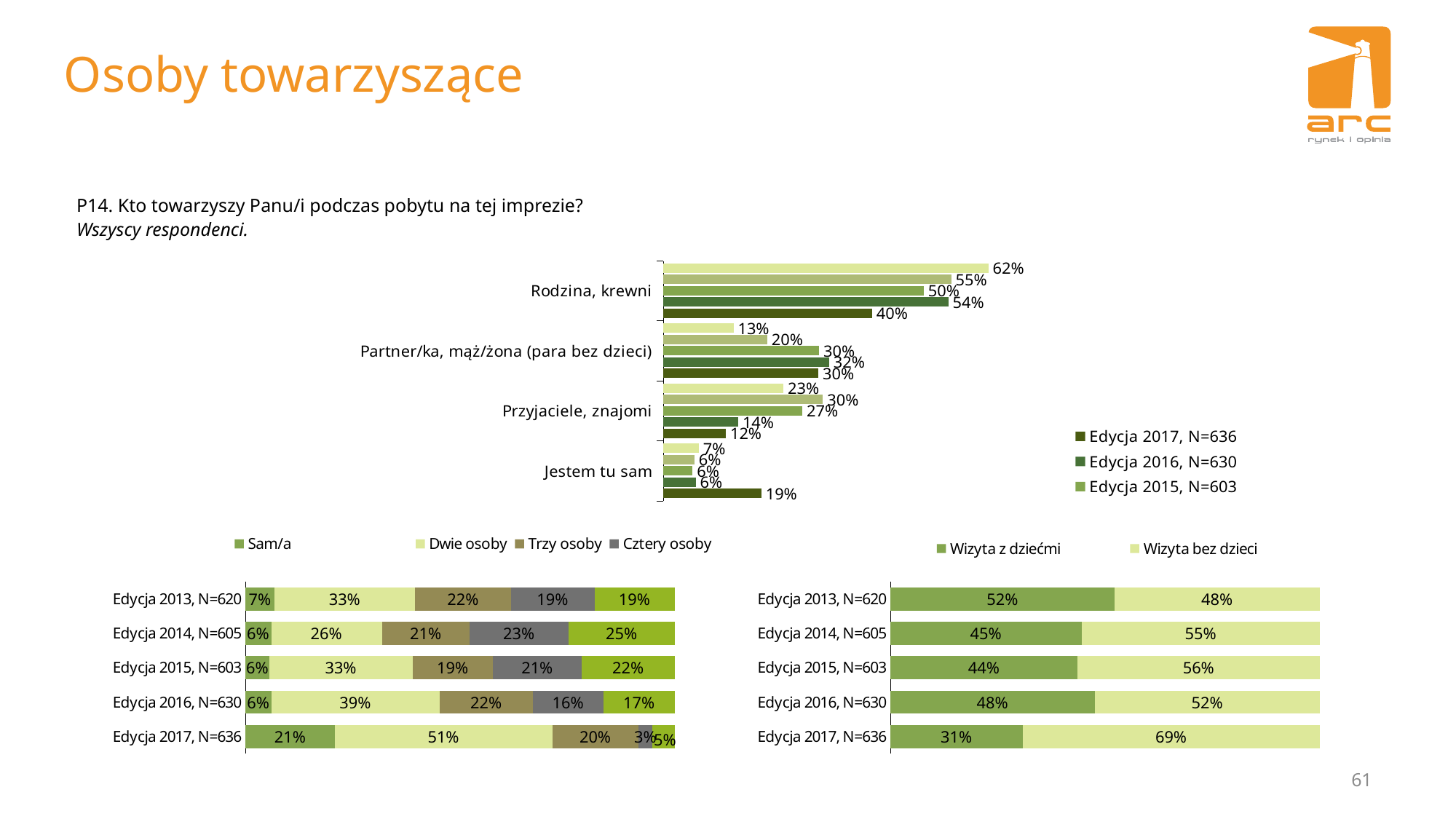
In the bottom-left chart, which edition has the highest Sam/a value? Edycja 2017, N=636 What type of chart is the bottom-right chart? Stacked bar chart In the bottom-right chart, is the Wizyta z dziećmi value larger for Edycja 2013, N=620 or Edycja 2015, N=603? Edycja 2013, N=620 In the bottom-left chart, what is the Cztery osoby value for Edycja 2014, N=605? 23% In the top chart, what is the value for Jestem tu sam in Edycja 2017, N=636? 19% In the bottom-right chart, which edition has the lowest Wizyta z dziećmi value? Edycja 2017, N=636 In the bottom-right chart, what is the Wizyta bez dzieci value for Edycja 2017, N=636? 69% In the top chart, what is the difference between the Edycja 2016, N=630 and Edycja 2017, N=636 values for Rodzina, krewni? 14 percentage points In the bottom-left chart, what is the Dwie osoby value for Edycja 2017, N=636? 51% In the top chart, what is the value for Rodzina, krewni in Edycja 2017, N=636? 40% In the top chart, what is the value for Przyjaciele, znajomi in Edycja 2016, N=630? 14% In the top chart, how many categories are shown on the vertical axis? 4